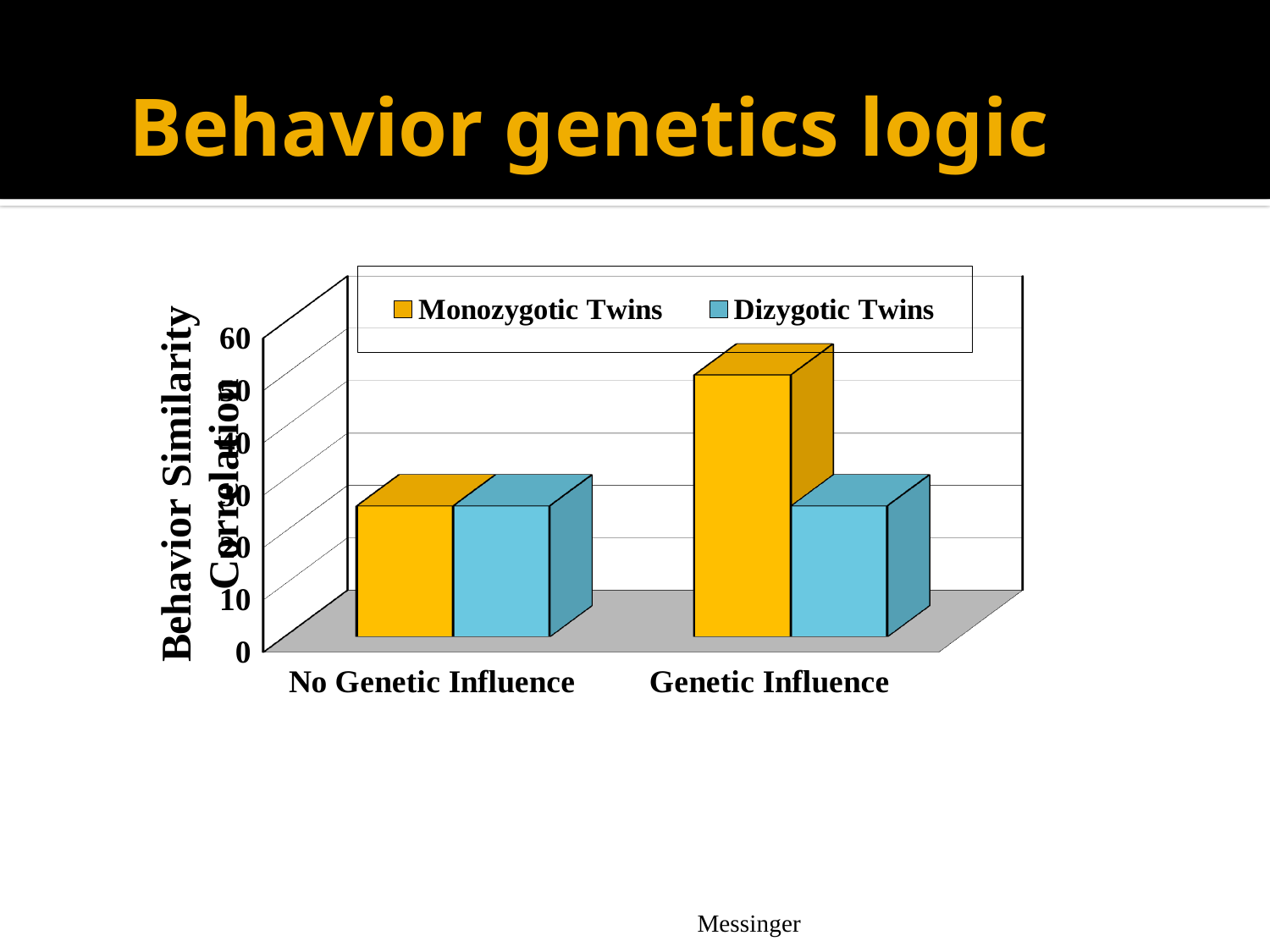
What kind of chart is shown on the slide? bar chart Is the value for Monozygotic Twins under Genetic Influence greater or less than 40? greater How many categories are shown on the x axis of the chart? 2 What is the label of the vertical axis of the chart? Behavior Similarity Correlation Which series are listed in the chart legend? Monozygotic Twins and Dizygotic Twins Which bar is the highest in the chart? Monozygotic Twins under Genetic Influence Is the value for Dizygotic Twins under Genetic Influence greater or less than 40? less Is the value for Monozygotic Twins under No Genetic Influence greater or less than 40? less Under Genetic Influence, which is larger: the Monozygotic Twins value or the Dizygotic Twins value? Monozygotic Twins How many series does the chart legend list? 2 Which category has the larger Monozygotic Twins value: No Genetic Influence or Genetic Influence? Genetic Influence